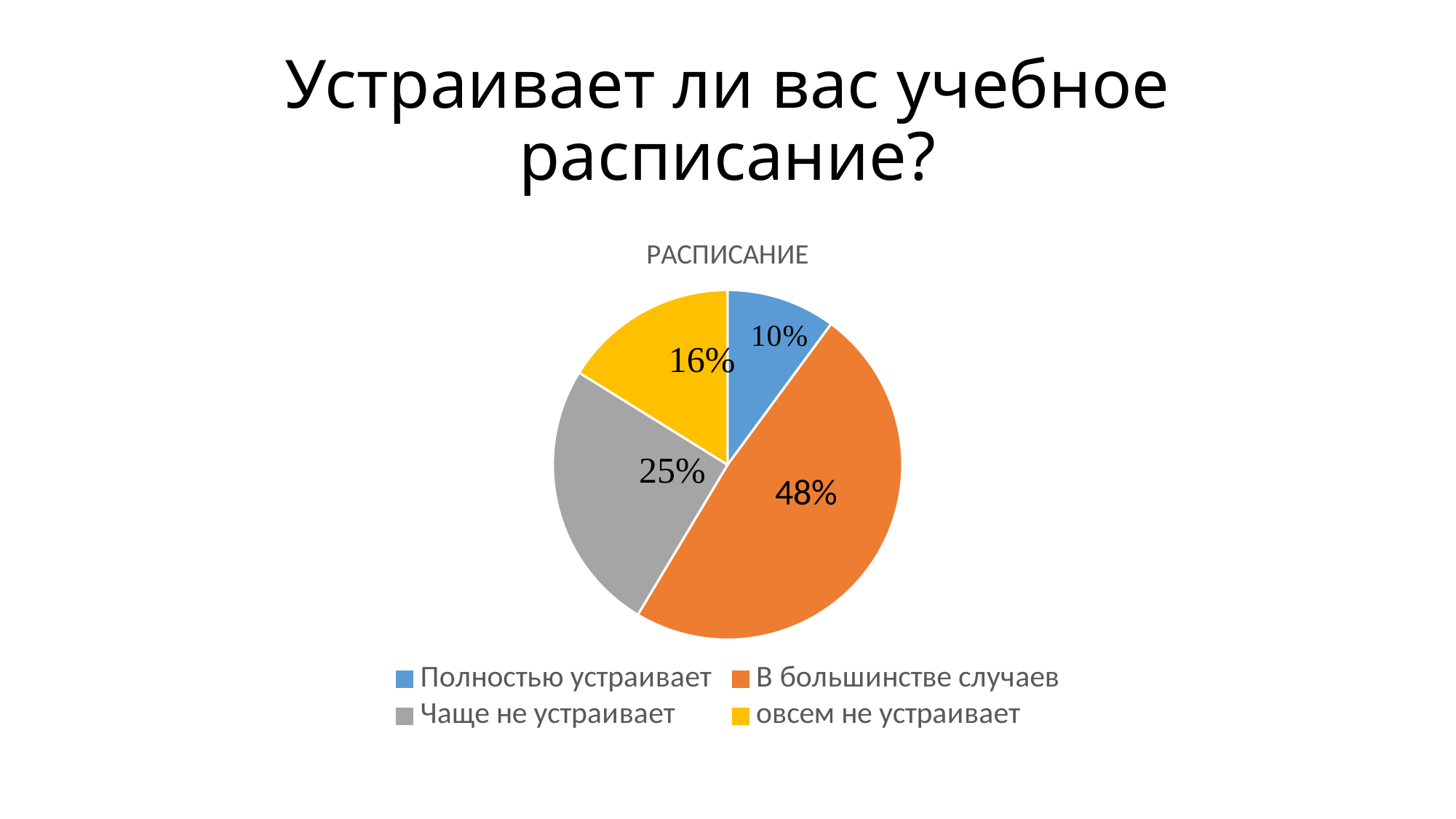
Which category has the smallest slice? Полностью устраивает What is the value for "Чаще не устраивает"? 25% Which is larger, the value for "Чаще не устраивает" or the value for "овсем не устраивает"? Чаще не устраивает What is the value for "Полностью устраивает"? 10% What share of the pie does "В большинстве случаев" take? 48% What kind of chart is shown on the slide? pie chart How many categories does the pie chart have? 4 What is the difference between the values for "В большинстве случаев" and "Чаще не устраивает"? 23% Which category has the largest slice? В большинстве случаев What is the chart's title? РАСПИСАНИЕ What colour is the slice for "овсем не устраивает"? yellow What is the value for "овсем не устраивает"? 16%